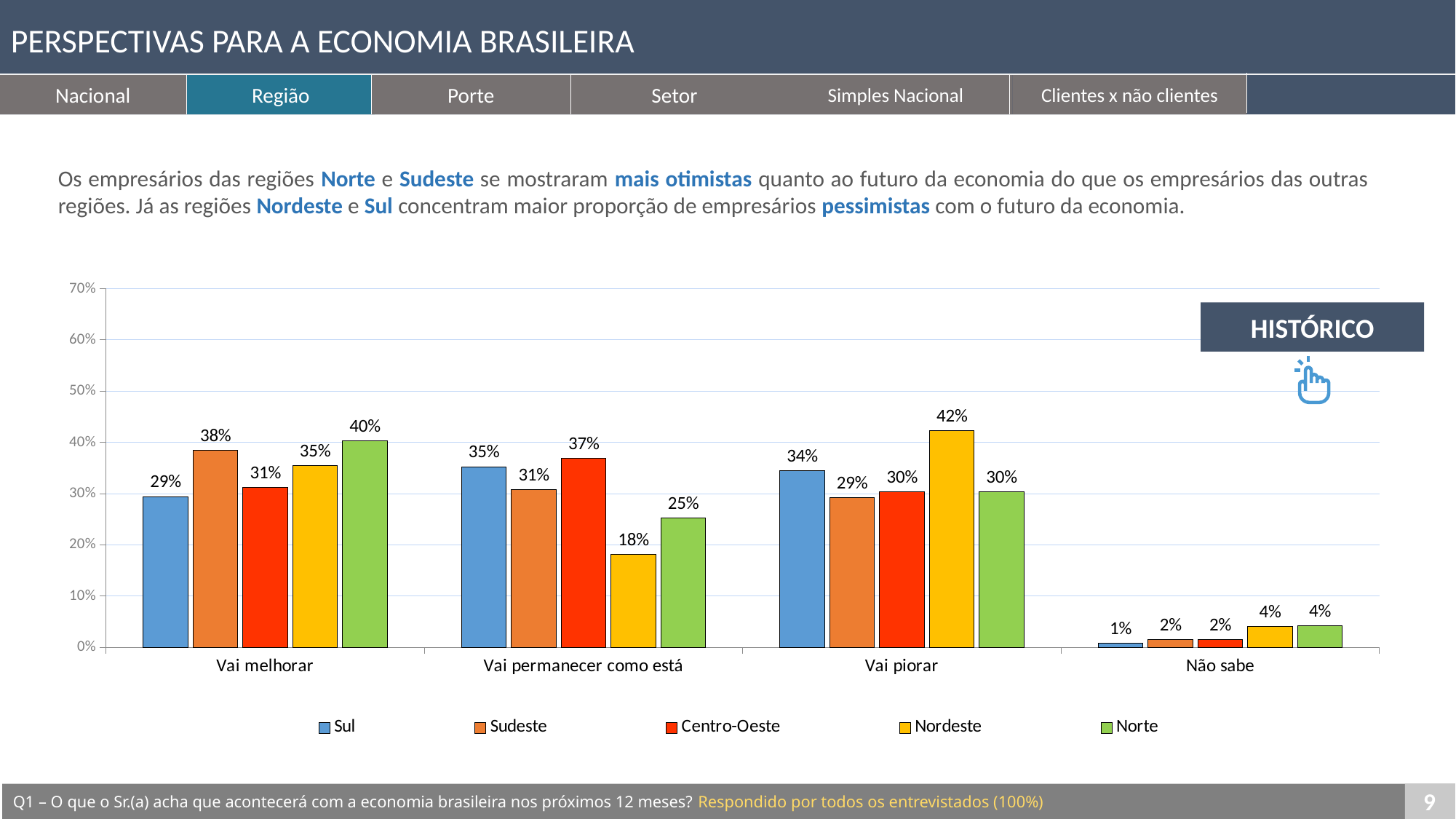
In the 'Vai melhorar' category, which is larger: the value for Sudeste or the value for Sul? Sudeste What is the value for Centro-Oeste in the 'Vai permanecer como está' category? 37% How many series does the legend list? 5 What is the difference between the Nordeste and Sul values in the 'Vai piorar' category? 8% How many categories are shown on the x axis? 4 What is the value for Nordeste in the 'Vai piorar' category? 42% Which region has the lowest value in the 'Vai permanecer como está' category? Nordeste What is the value for Norte in the 'Vai melhorar' category? 40% Is the value for Nordeste in the 'Vai piorar' category greater or less than 40%? greater Which region has the highest value in the 'Vai melhorar' category? Norte Which colour represents Nordeste in the legend? yellow What kind of chart is shown on the slide? bar chart